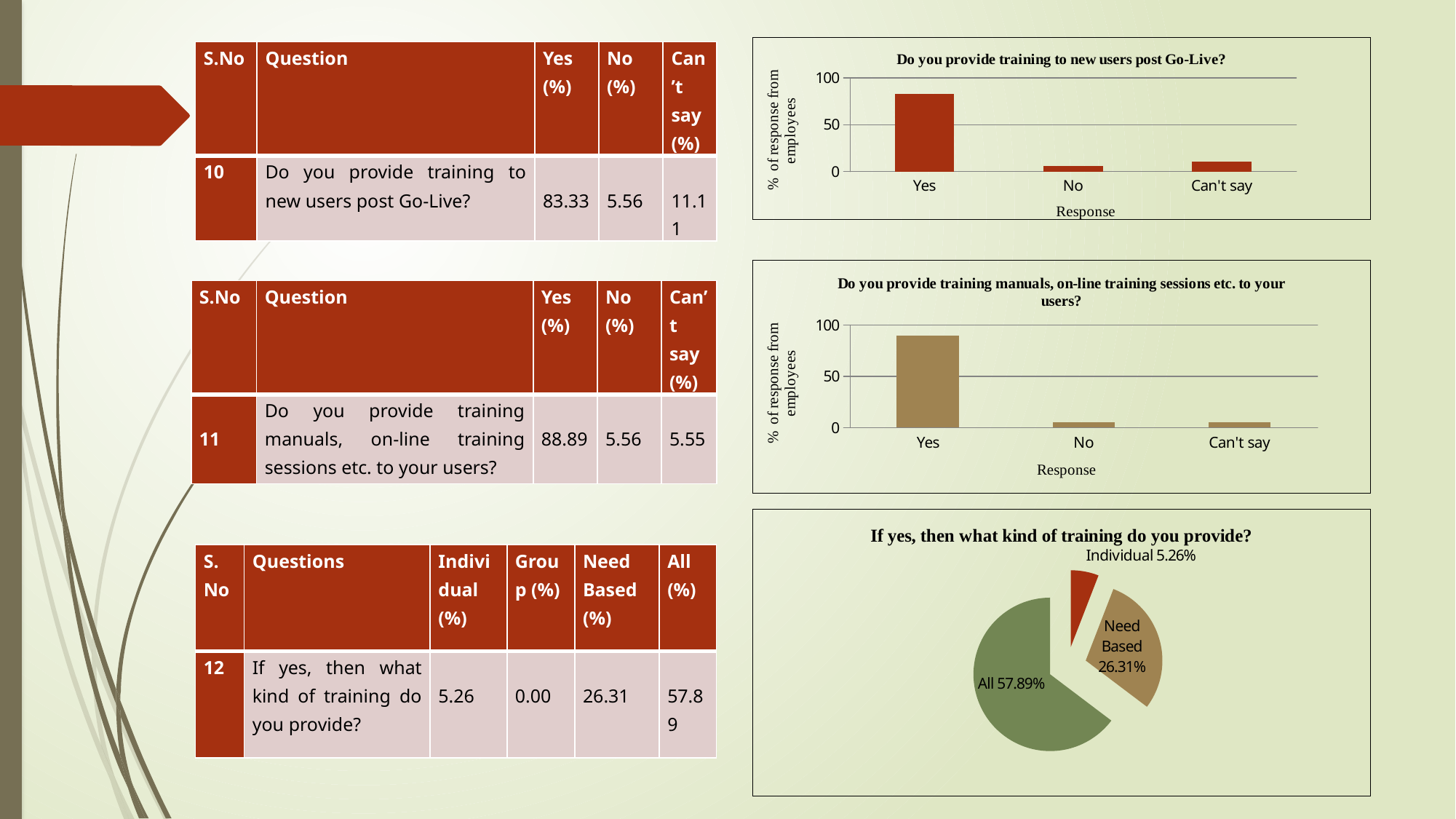
In the chart "Do you provide training manuals, on-line training sessions etc. to your users?", is the value for No greater or less than 50? less What kind of chart is the bottom-right chart titled "If yes, then what kind of training do you provide?"? pie chart In the pie chart "If yes, then what kind of training do you provide?", what share does the All slice have? 57.89% What is the y-axis label on the chart "Do you provide training to new users post Go-Live?"? % of response from employees In the chart "Do you provide training manuals, on-line training sessions etc. to your users?", which response has the highest value? Yes In the pie chart "If yes, then what kind of training do you provide?", which slice is the smallest? Individual In the chart "Do you provide training to new users post Go-Live?", is the value for Can't say greater or less than 50? less In the chart "Do you provide training to new users post Go-Live?", which response has the highest value? Yes How many response categories are shown in the chart "Do you provide training manuals, on-line training sessions etc. to your users?"? 3 What kind of chart is the top-right chart titled "Do you provide training to new users post Go-Live?"? bar chart In the pie chart "If yes, then what kind of training do you provide?", what is the value for Need Based? 26.31% In the chart "Do you provide training to new users post Go-Live?", is the value for Yes greater or less than 50? greater